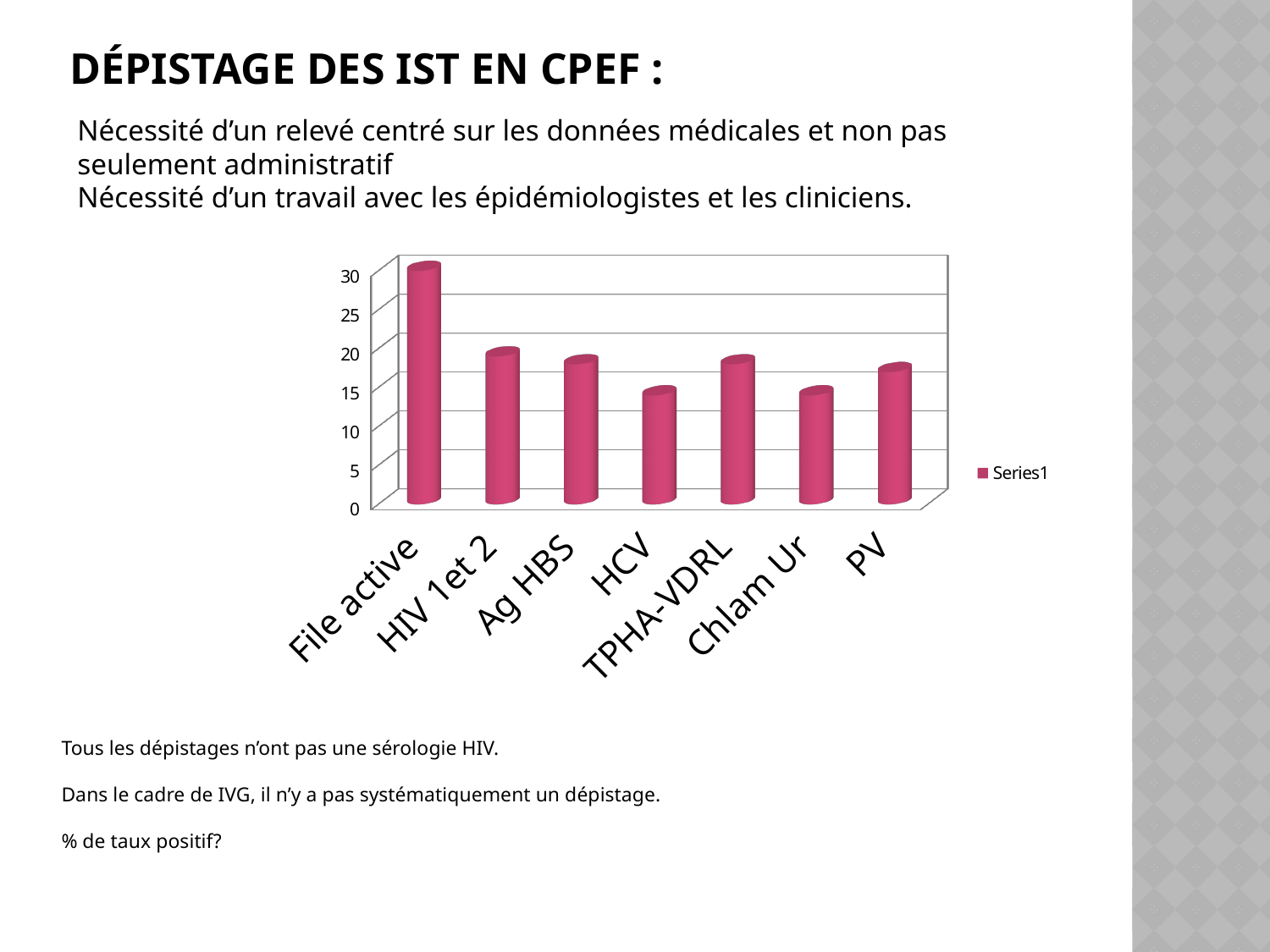
How many series does the chart legend list? 1 What is the name of the series shown in the chart legend? Series1 Which is larger, the value for HIV 1et 2 or the value for HCV? HIV 1et 2 Is the value for Chlam Ur greater or less than 20? less Is the value for File active greater or less than 25? greater Is the value for TPHA-VDRL greater or less than 25? less How many categories are shown on the x axis of the chart? 7 What kind of chart is shown on the slide? bar chart Which category has the highest bar in the chart? File active Which is larger, the value for File active or the value for HIV 1et 2? File active